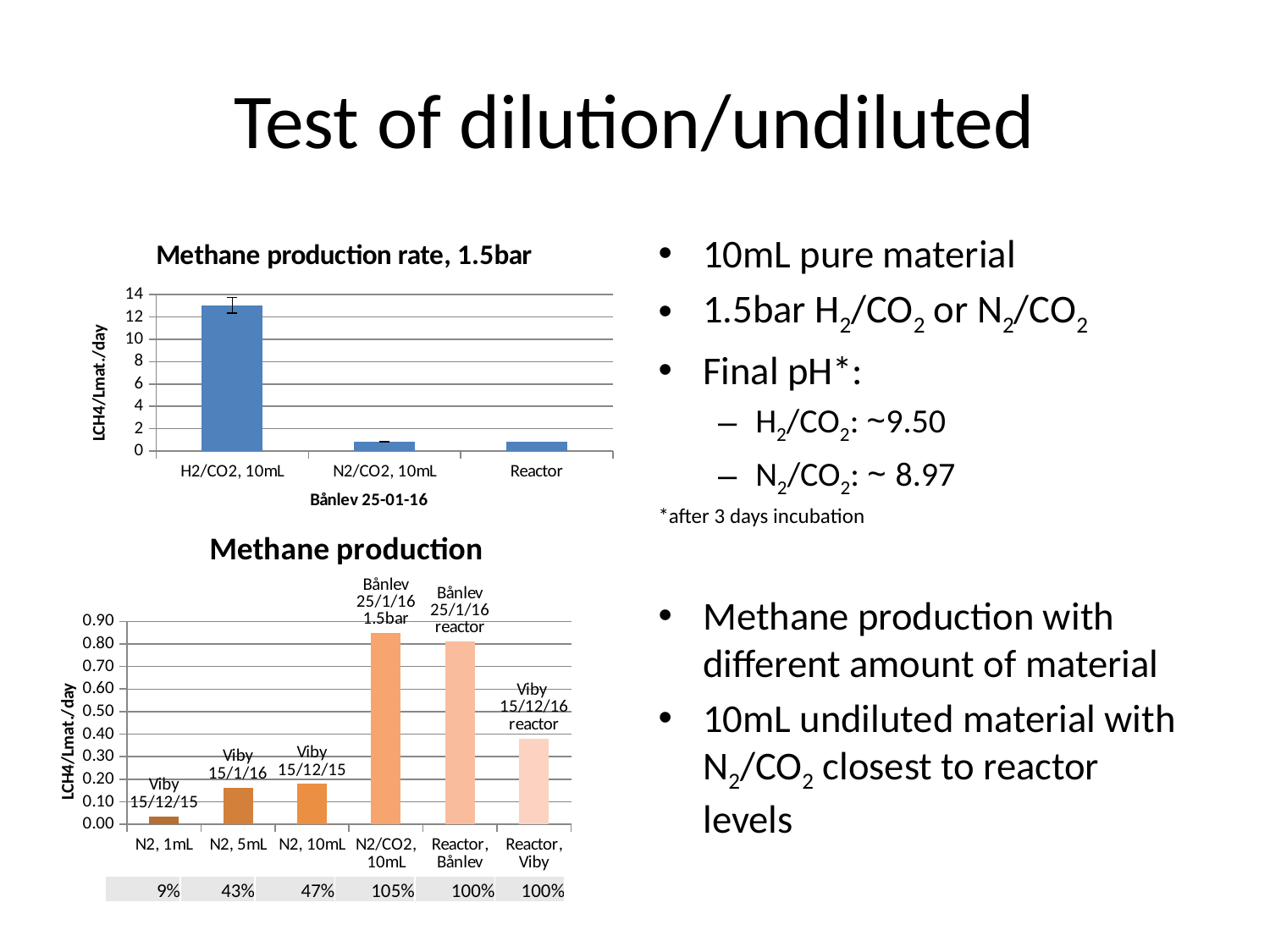
In the 'Methane production' chart, is the value for Reactor, Viby greater or less than 0.50? less In the 'Methane production rate, 1.5bar' chart, how many categories are plotted? 3 In the 'Methane production' chart, which is larger, the value for Reactor, Bånlev or the value for Reactor, Viby? Reactor, Bånlev In the 'Methane production rate, 1.5bar' chart, what kind of chart is shown? bar chart In the 'Methane production rate, 1.5bar' chart, is the value for N2/CO2, 10mL greater or less than 2? less In the 'Methane production' chart, which category has the lowest methane production? N2, 1mL In the 'Methane production rate, 1.5bar' chart, which category has the highest methane production rate? H2/CO2, 10mL In the 'Methane production' chart, what percentage is shown in the table row for N2, 5mL? 43% In the 'Methane production' chart, what percentage is shown in the table row for N2/CO2, 10mL? 105% In the 'Methane production rate, 1.5bar' chart, is the value for H2/CO2, 10mL greater or less than 12? greater In the 'Methane production' chart, how many categories are plotted on the x axis? 6 In the 'Methane production' chart, which category has the highest methane production? N2/CO2, 10mL